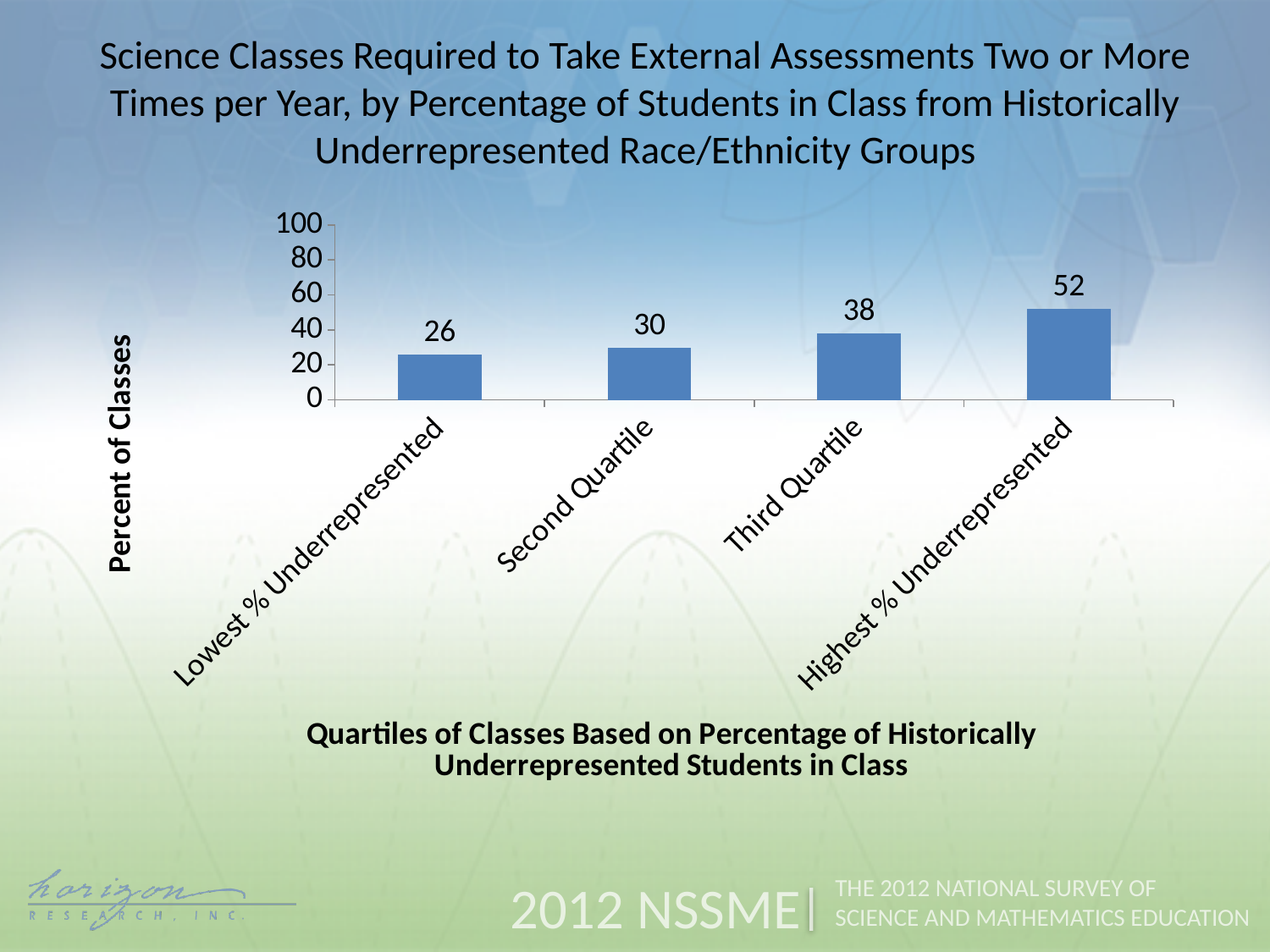
What is the difference between the values for Highest % Underrepresented and Lowest % Underrepresented? 26 What kind of chart is shown on the slide? bar chart What is the value for Third Quartile? 38 How many categories are shown on the x axis? 4 Do the values rise or fall from left to right along the x axis? rise What is the value for Highest % Underrepresented? 52 Which is larger, the value for Third Quartile or the value for Second Quartile? Third Quartile What is the value for Lowest % Underrepresented? 26 Which category has the highest value? Highest % Underrepresented What is the value for Second Quartile? 30 Is the value for Highest % Underrepresented greater or less than 40? greater Which category has the lowest value? Lowest % Underrepresented